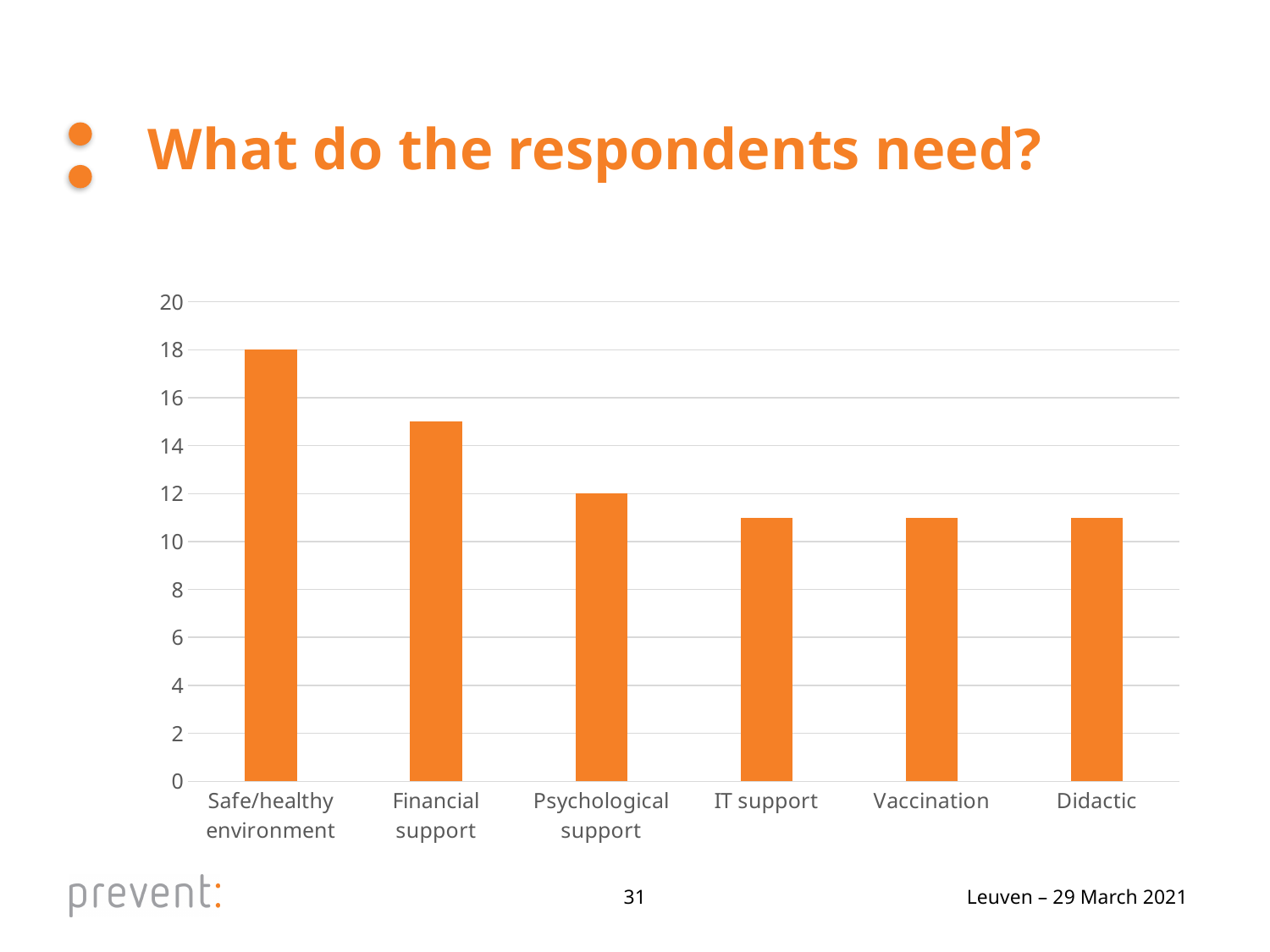
Do the values rise or fall from left to right along the x axis? fall What is the difference between the values for Safe/healthy environment and Psychological support? 6 Which is larger, the value for Safe/healthy environment or the value for Financial support? Safe/healthy environment How many categories are shown on the x axis? 6 Is the value for Vaccination greater or less than 12? less Which is larger, the value for Financial support or the value for IT support? Financial support What is the value for Safe/healthy environment? 18 What is the value for Psychological support? 12 Is the value for Didactic greater or less than 10? greater What kind of chart is shown on the slide? bar chart Which category has the highest value? Safe/healthy environment Is the value for Financial support greater or less than 14? greater